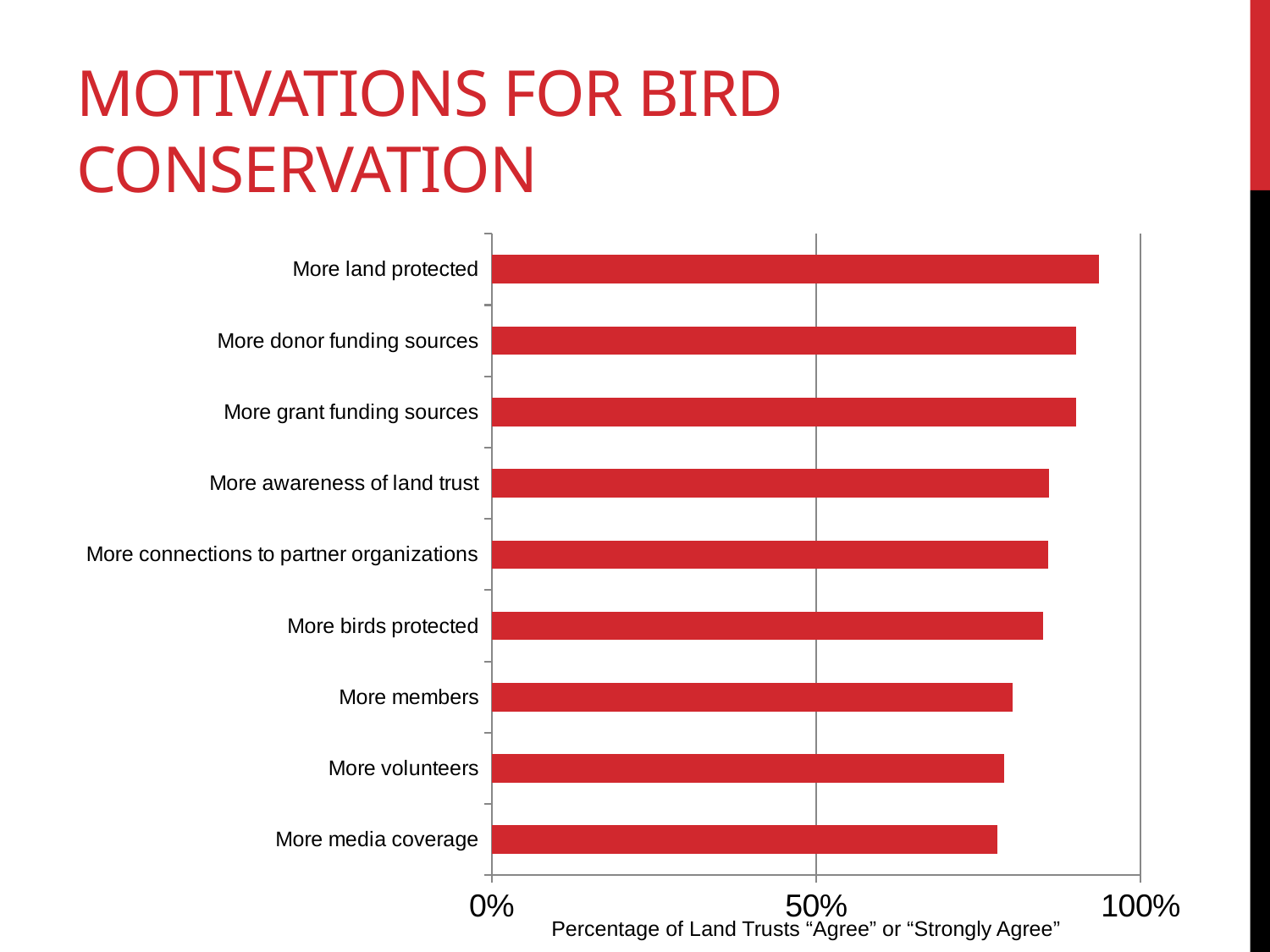
What is the label on the horizontal axis of the chart? Percentage of Land Trusts "Agree" or "Strongly Agree" Is the value for More land protected greater or less than 100%? less Which is larger, the value for More donor funding sources or the value for More volunteers? More donor funding sources What colour are the bars in the chart? red Is the value for More volunteers greater or less than 50%? greater Which category has the highest percentage of land trusts agreeing or strongly agreeing? More land protected How many categories (bars) does the chart show? 9 Which is larger, the value for More land protected or the value for More media coverage? More land protected What kind of chart is shown on the slide? bar chart Is the value for More media coverage greater or less than 50%? greater Which is larger, the value for More birds protected or the value for More members? More birds protected